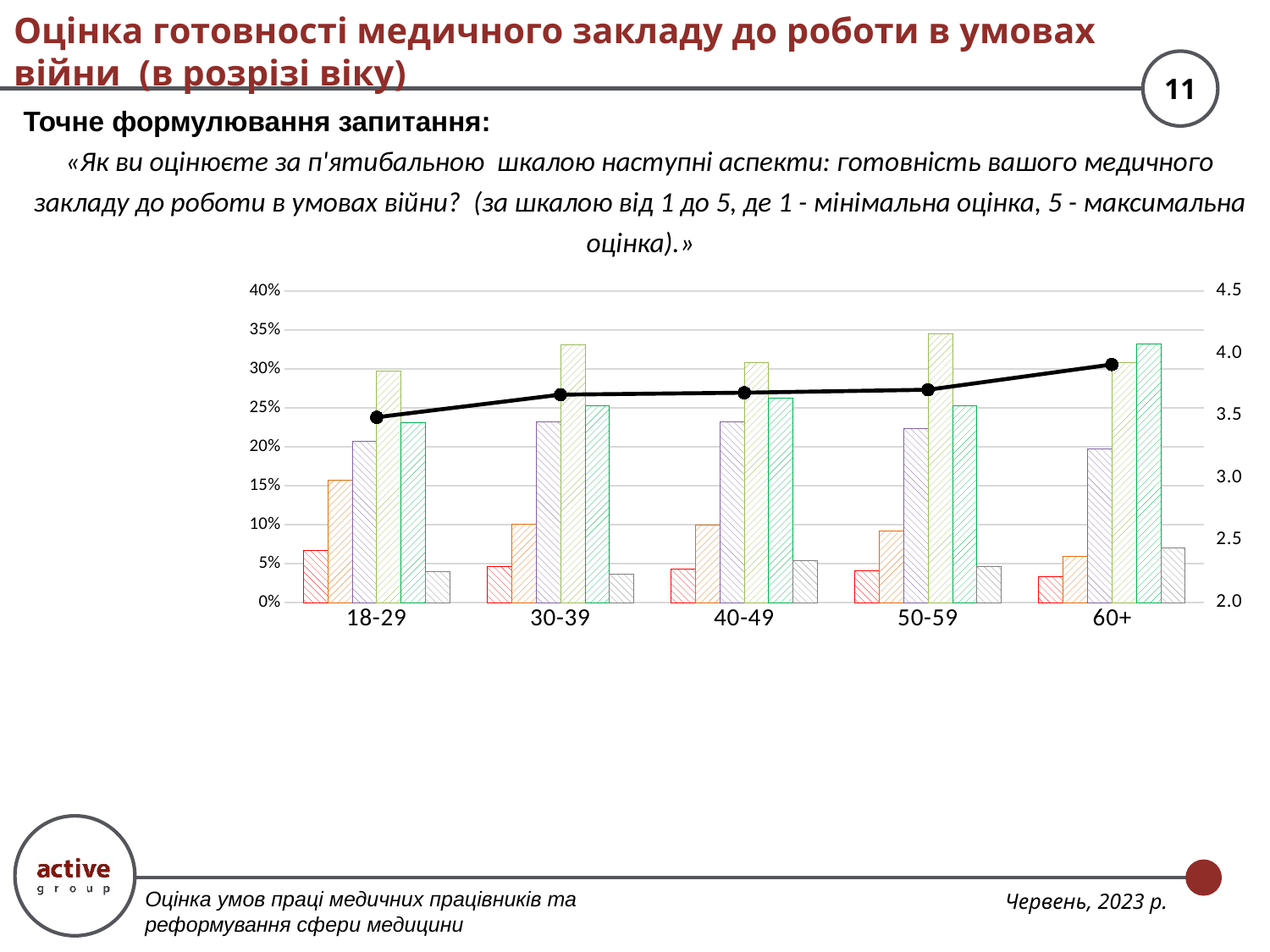
Is the black line value for the 18-29 group greater or less than 3.0 on the right axis? greater How many age groups are shown on the x axis of the chart? 5 What is the highest value shown on the left (percentage) axis of the chart? 40% Is the black line value for the 30-39 group greater or less than 3.5 on the right axis? greater Is the black line value for the 60+ group greater or less than 4.0 on the right axis? less What type of chart is shown on the slide? A bar chart combined with a line Does the black line on the chart rise or fall from the 18-29 group to the 60+ group? Rises For which age group does the black line reach its highest point? 60+ Which has the higher black line value: the 60+ group or the 18-29 group? 60+ Which age group is the last category on the x axis of the chart? 60+ For which age group is the black line at its lowest point? 18-29